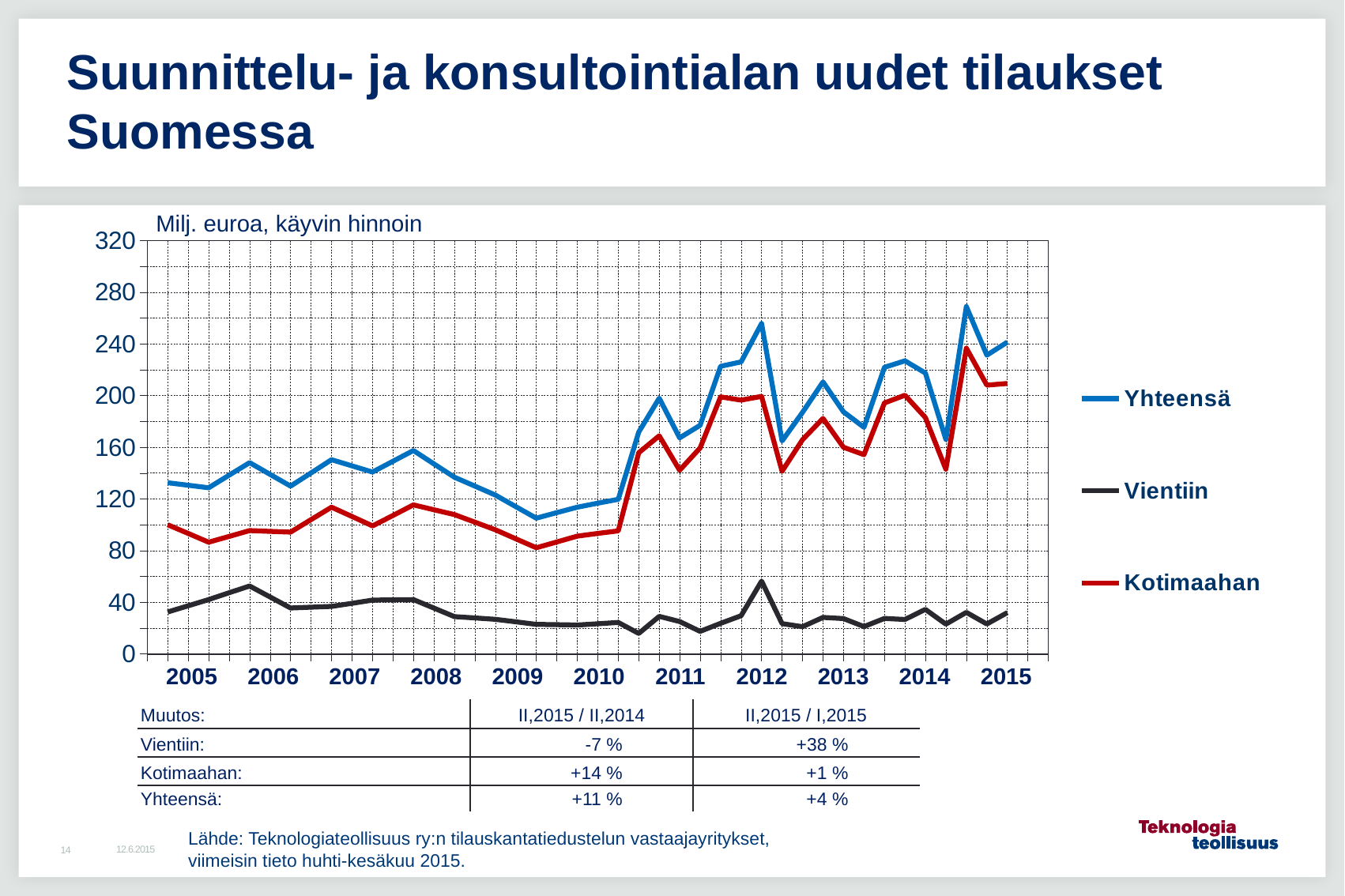
Which series has the highest values throughout the chart? Yhteensä Which series is drawn in red in the chart? Kotimaahan What kind of chart is shown on the slide? line chart Is the last value of Vientiin in 2015 greater or less than 40? less Is the peak value of Vientiin in 2012 greater or less than 40? greater What unit label is shown above the chart's y axis? Milj. euroa, käyvin hinnoin Which series has the lowest values throughout the chart? Vientiin Is the peak value of Yhteensä in 2014 greater or less than 240? greater Does the Kotimaahan series rise or fall between 2010 and 2011? rise Which is larger in 2012, the value for Kotimaahan or the value for Vientiin? Kotimaahan How many series does the chart legend list? 3